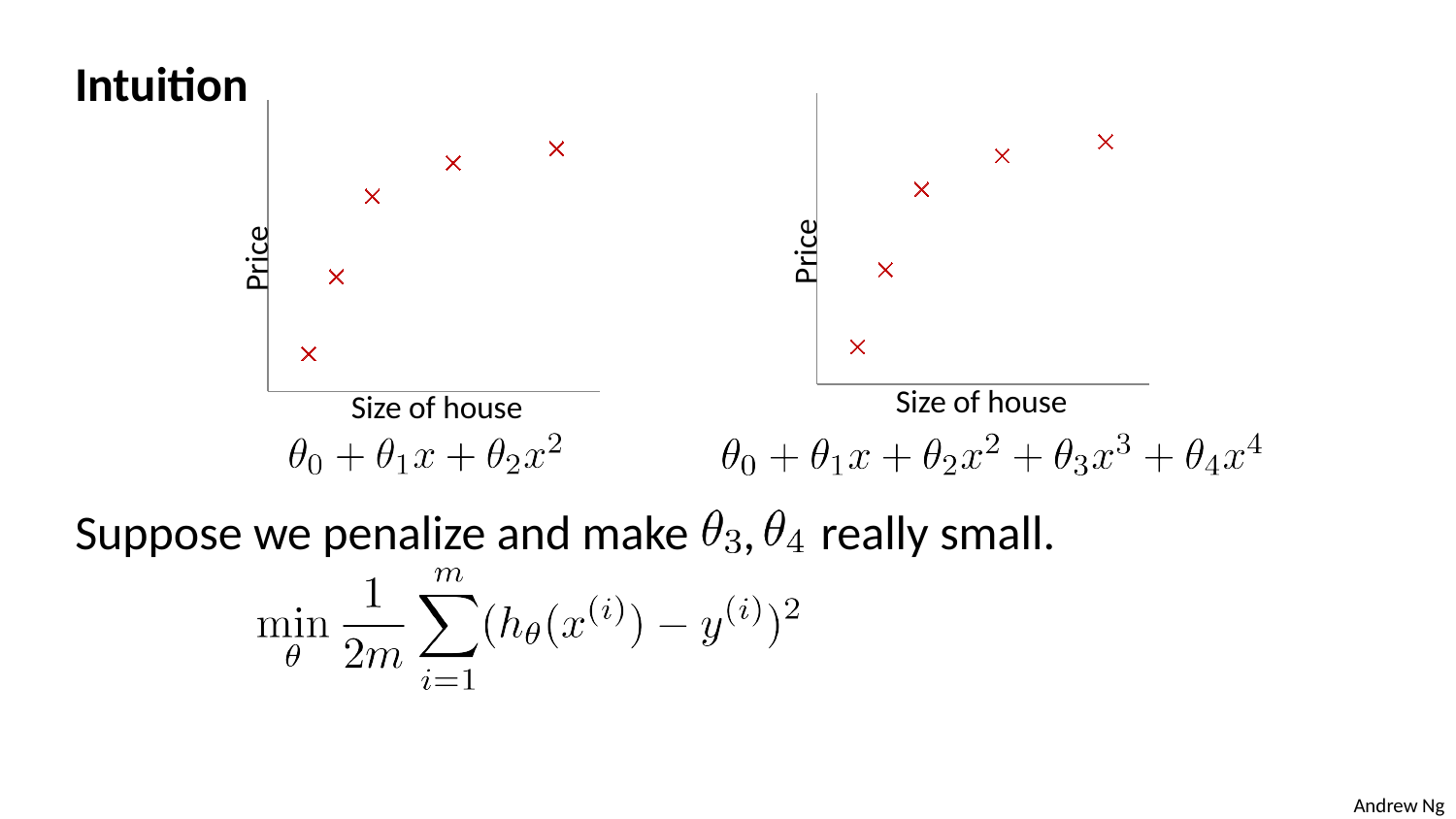
In the left chart, does Price rise or fall as Size of house increases? rise In the right chart, does Price rise or fall as Size of house increases? rise How many charts are shown on the slide? 2 What kind of chart is the left chart on the slide? scatter plot What is the x-axis label of the left chart? Size of house What is the y-axis label of the right chart? Price What kind of chart is the right chart on the slide? scatter plot How many data points are plotted in the right chart? 5 How many data points are plotted in the left chart? 5